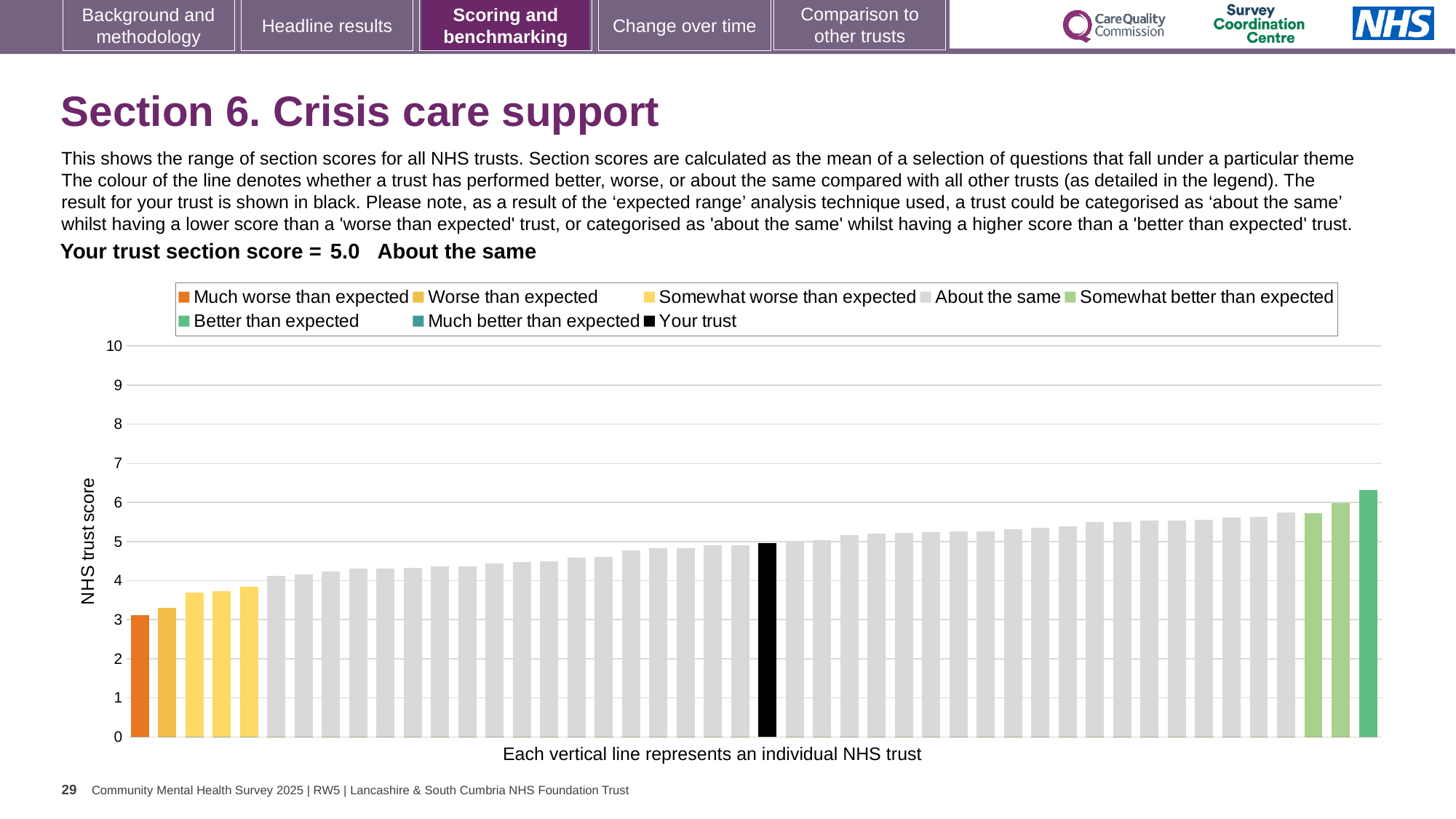
Which category is your trust placed in for this section? About the same What is the section score for your trust? 5.0 Is the value of the lowest bar (the orange bar) greater or less than 4? less Which legend category does the lowest bar on the chart belong to? Much worse than expected What is the label on the vertical axis of the chart? NHS trust score Do the bar values rise or fall from left to right across the chart? rise How many entries does the chart legend list? 8 Is the value of the tallest bar greater or less than 5? greater Is the value for your trust (the black bar) greater or less than 4? greater Which legend category does the tallest bar on the chart belong to? Better than expected What kind of chart is shown on the slide? bar chart